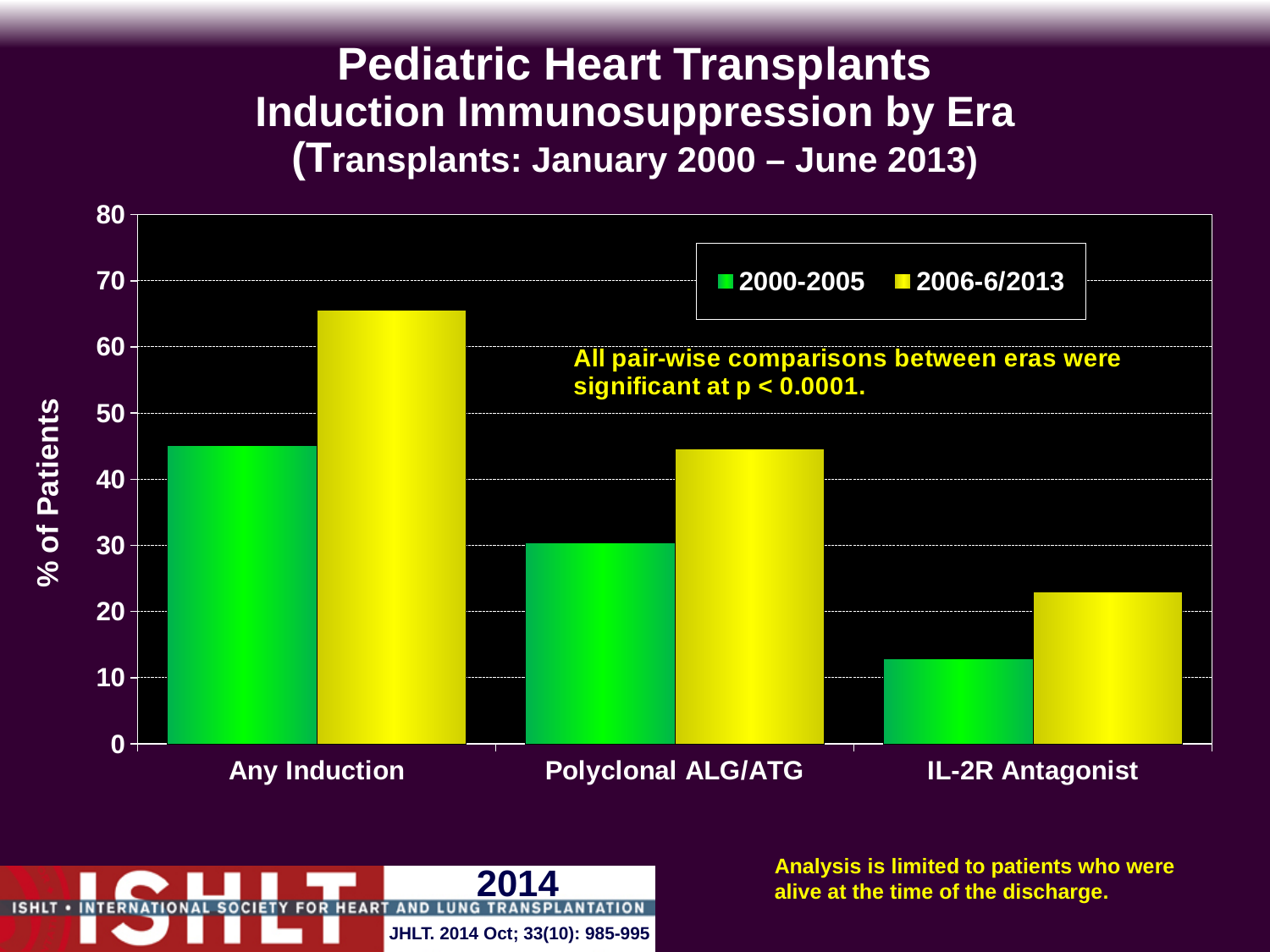
What kind of chart is shown on the slide? bar chart What is the label of the y axis? % of Patients How many series does the legend list? 2 Is the value for IL-2R Antagonist in 2006-6/2013 greater or less than 30? less Is the value for Any Induction in 2000-2005 greater or less than 50? less For Polyclonal ALG/ATG, which era has the larger value, 2000-2005 or 2006-6/2013? 2006-6/2013 Which colour represents the 2006-6/2013 series in the legend? yellow Is the value for Any Induction in 2006-6/2013 greater or less than 60? greater How many categories are shown on the x axis? 3 Which category has the lowest value for the 2000-2005 series? IL-2R Antagonist Which category has the highest value for the 2006-6/2013 series? Any Induction